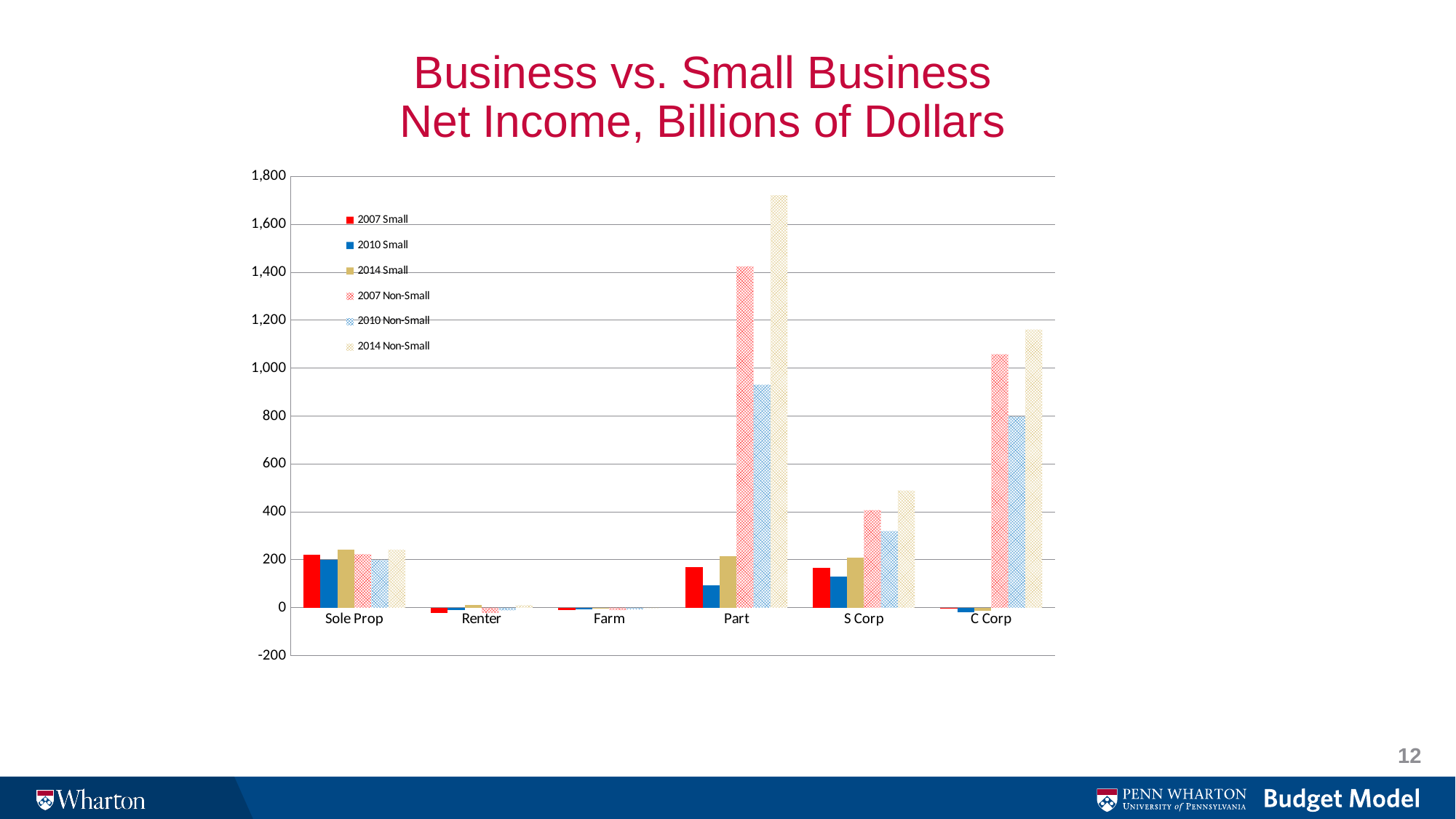
What kind of chart is shown on the slide? Bar chart How many categories are shown on the x axis of the chart? 6 Which category has the highest 2014 Non-Small value? Part How many series does the chart's legend list? 6 Which is larger, the 2007 Non-Small value for Part or the 2007 Non-Small value for C Corp? Part Is the 2010 Non-Small value for Part greater or less than 800? greater Is the 2014 Non-Small value for C Corp greater or less than 1,000? greater What is the title of the chart on the slide? Business vs. Small Business Net Income, Billions of Dollars Is the 2010 Non-Small value for S Corp greater or less than 400? less Which category has the highest 2007 Small value? Sole Prop